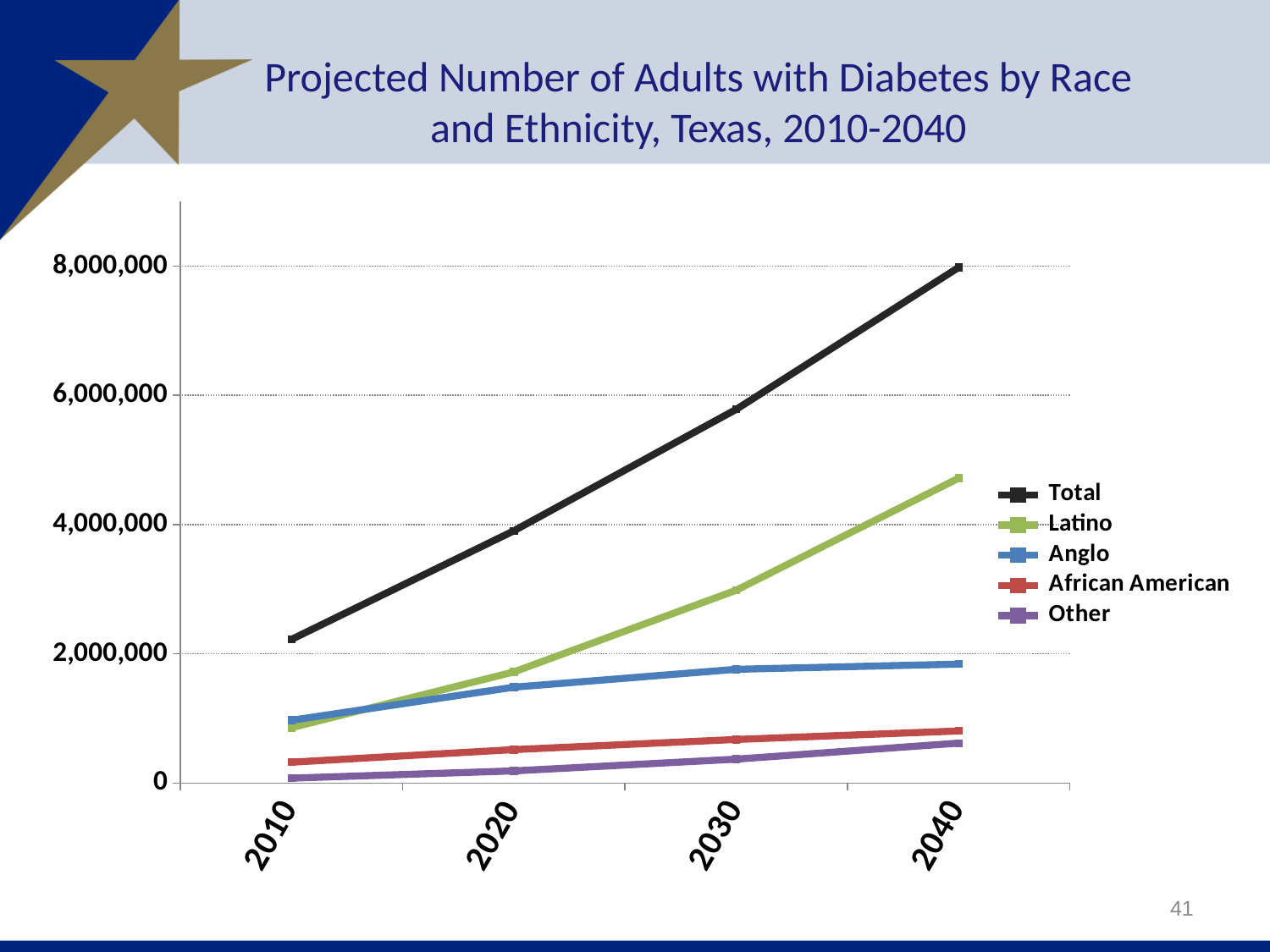
Is the value for Latino in 2040 greater or less than 4,000,000? greater Which is larger in 2030, the value for African American or the value for Other? African American Which series has the lowest value in 2040? Other Which series has the highest value in 2040? Total What kind of chart is shown on the slide? line chart Is the value for Latino in 2030 greater or less than 2,000,000? greater How many years are plotted along the x axis? 4 What colour is the line for the Latino series? green Does the Total series rise or fall from 2010 to 2040? rise Which is larger in 2040, the value for Latino or the value for Anglo? Latino How many series does the legend list? 5 Is the value for Anglo in 2040 greater or less than 2,000,000? less